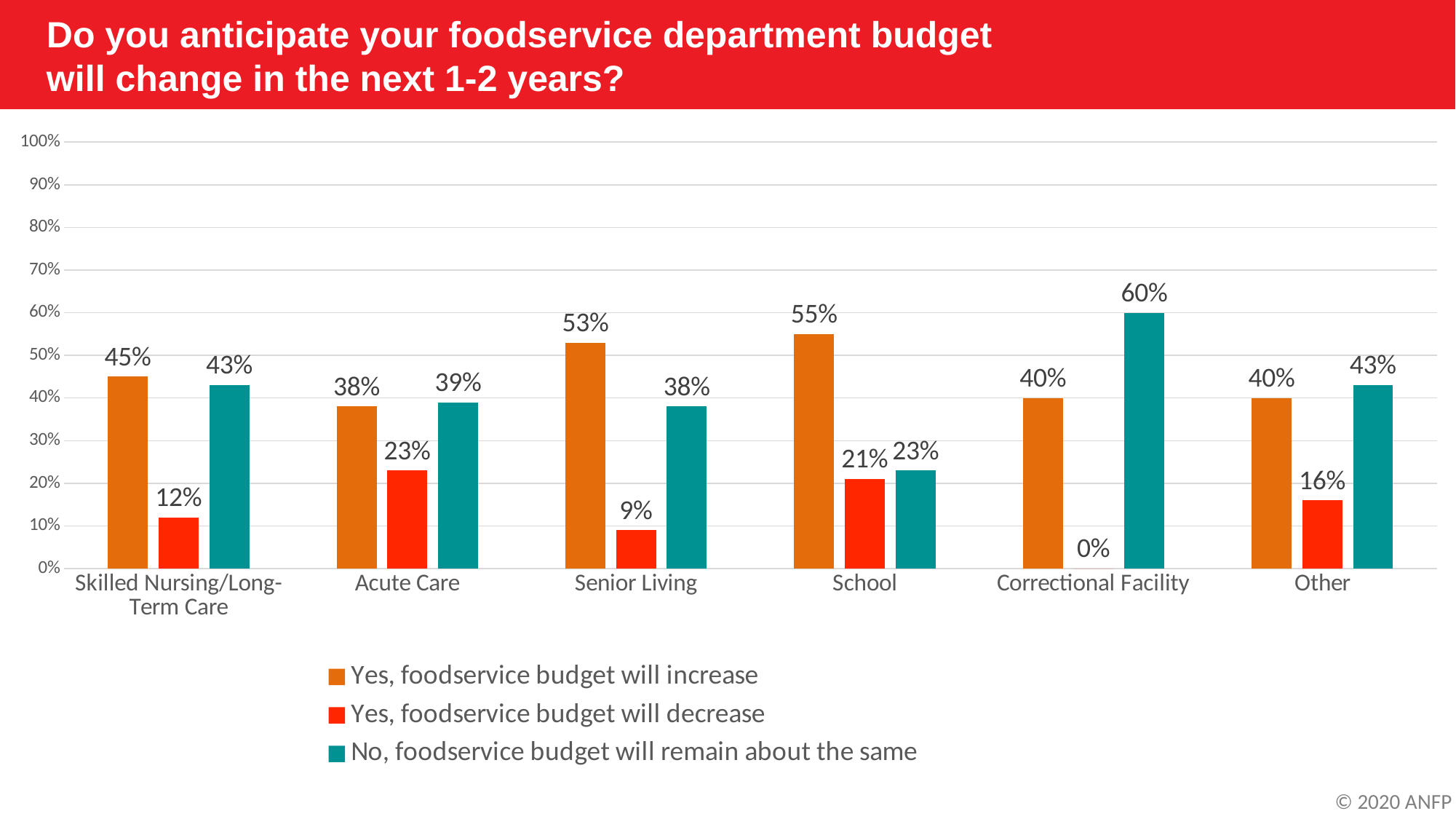
For Skilled Nursing/Long-Term Care, which is larger: the 'will increase' value or the 'will remain about the same' value? Yes, foodservice budget will increase What percentage of Correctional Facility respondents said their foodservice budget will remain about the same? 60% Which category has the lowest value for 'Yes, foodservice budget will decrease'? Correctional Facility Which category has the highest value for 'No, foodservice budget will remain about the same'? Correctional Facility Which category has the highest value for 'Yes, foodservice budget will increase'? School What colour represents 'Yes, foodservice budget will decrease' in the legend? Red What percentage of Acute Care respondents said their foodservice budget will decrease? 23% How many categories are shown on the x axis? 6 What kind of chart is shown on the slide? Bar chart What is the difference between the 'will increase' and 'will decrease' values for Senior Living? 44% How many series does the legend list? 3 What percentage of School respondents said their foodservice budget will increase? 55%